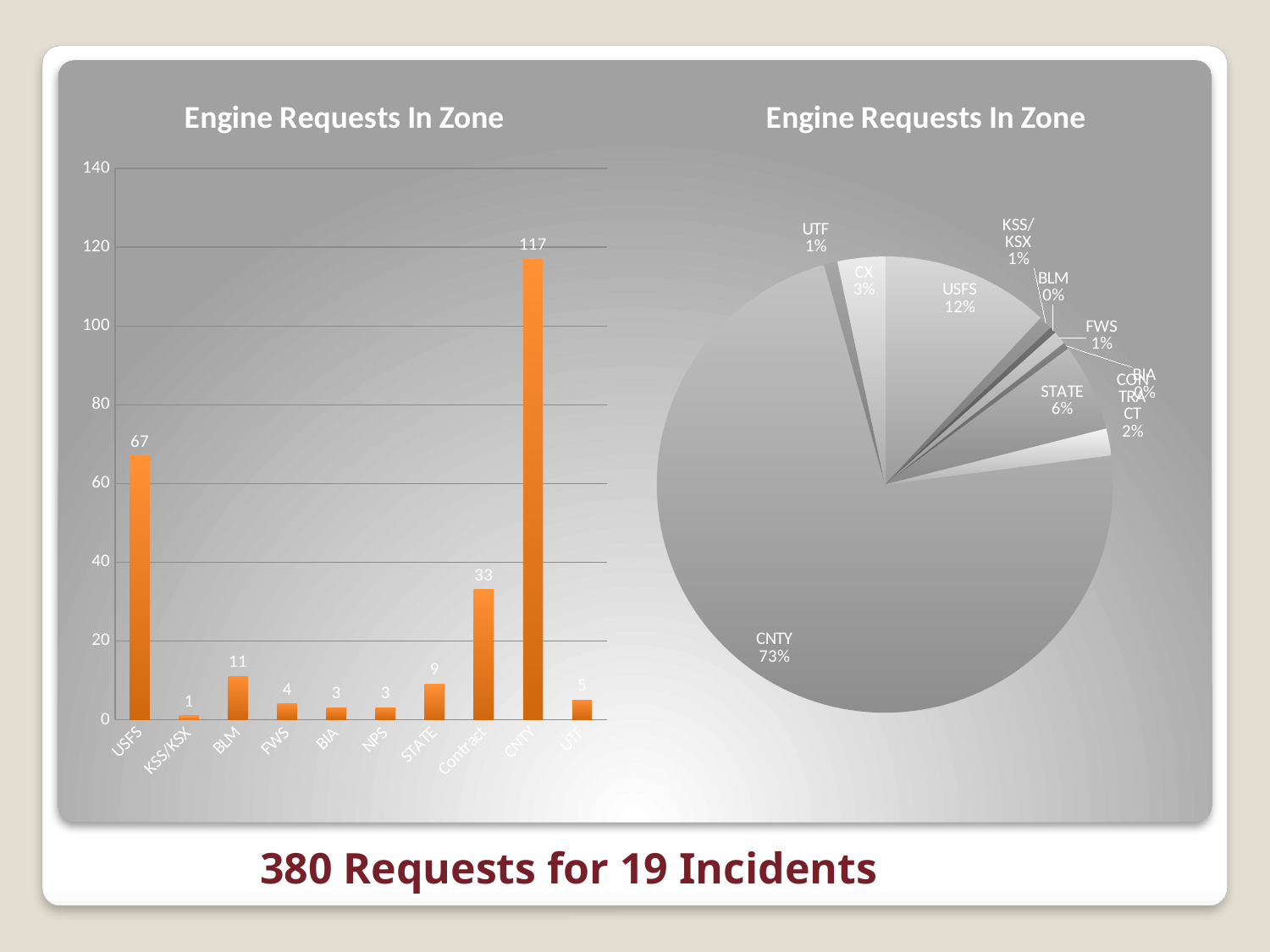
On the bar chart on the left, what is the value for USFS? 67 On the pie chart on the right, what share does USFS have? 12% On the bar chart on the left, what is the value for Contract? 33 On the bar chart on the left, which category has the highest value? CNTY On the bar chart on the left, how many categories are shown on the x axis? 10 What is the title of the pie chart on the right? Engine Requests In Zone What kind of chart is the chart on the left of the slide? Bar chart On the bar chart on the left, what is the value for CNTY? 117 On the bar chart on the left, which is larger, the value for BLM or the value for STATE? BLM On the bar chart on the left, which category has the lowest value? KSS/KSX On the bar chart on the left, what is the difference between the values for CNTY and USFS? 50 On the pie chart on the right, what share does CNTY have? 73%